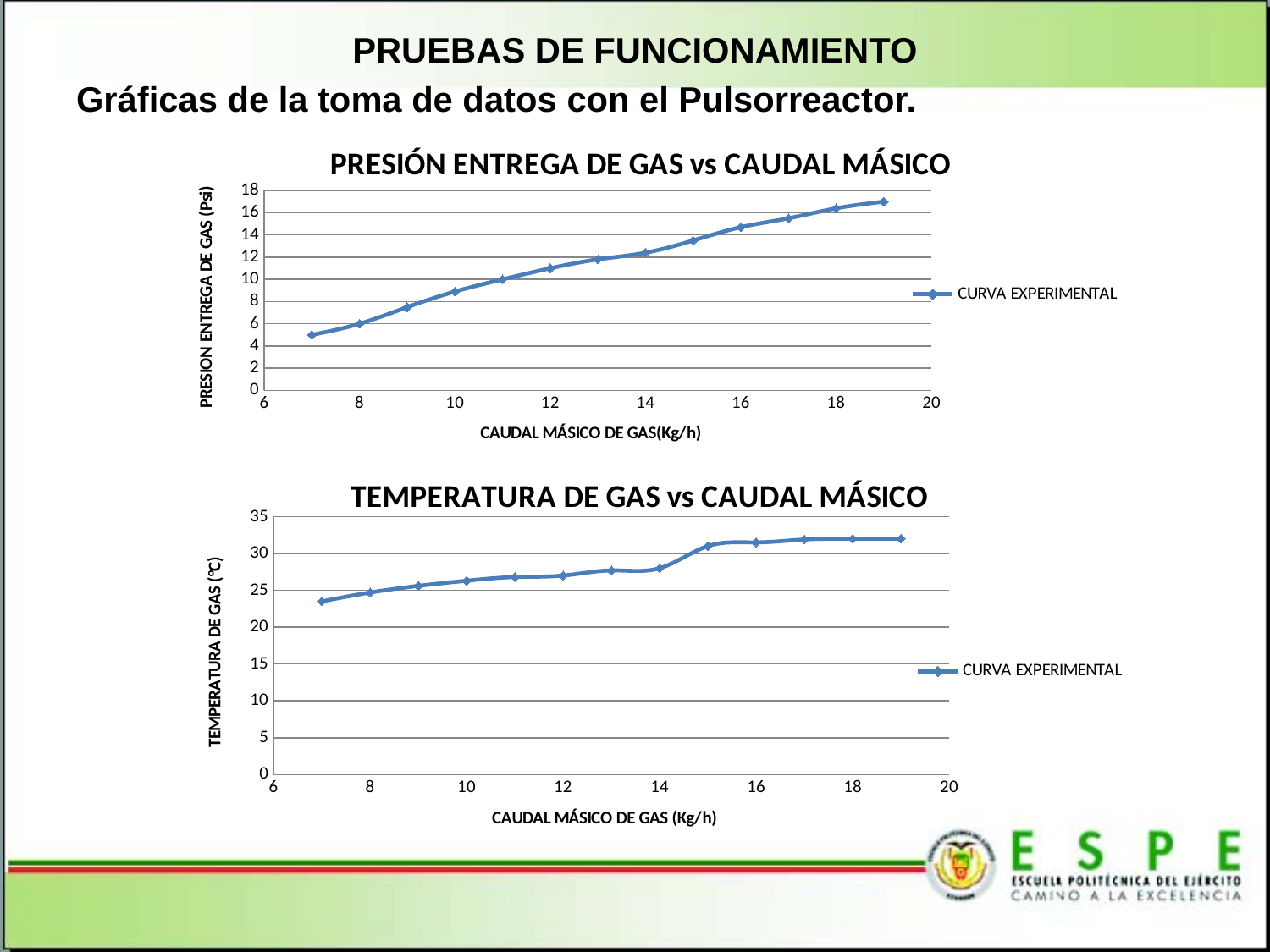
In the 'PRESIÓN ENTREGA DE GAS vs CAUDAL MÁSICO' chart, is the pressure at a mass flow of 7 Kg/h greater or less than 6? less In the 'PRESIÓN ENTREGA DE GAS vs CAUDAL MÁSICO' chart, is the pressure at a mass flow of 19 Kg/h greater or less than 16? greater In the 'TEMPERATURA DE GAS vs CAUDAL MÁSICO' chart, is the temperature at a mass flow of 19 Kg/h greater or less than 30? greater In the 'TEMPERATURA DE GAS vs CAUDAL MÁSICO' chart, at which mass flow value is the temperature lowest? 7 In the 'PRESIÓN ENTREGA DE GAS vs CAUDAL MÁSICO' chart, how many series does the legend list? 1 In the 'TEMPERATURA DE GAS vs CAUDAL MÁSICO' chart, which is larger: the temperature at 14 Kg/h or at 16 Kg/h? 16 Kg/h In the 'PRESIÓN ENTREGA DE GAS vs CAUDAL MÁSICO' chart, do the values rise or fall as the mass flow increases along the x axis? rise In the 'PRESIÓN ENTREGA DE GAS vs CAUDAL MÁSICO' chart, at which mass flow value is the pressure highest? 19 What is the name of the series in the legend of the 'TEMPERATURA DE GAS vs CAUDAL MÁSICO' chart? CURVA EXPERIMENTAL In the 'PRESIÓN ENTREGA DE GAS vs CAUDAL MÁSICO' chart, how many data points are plotted? 13 What kind of chart is the 'PRESIÓN ENTREGA DE GAS vs CAUDAL MÁSICO' chart? line chart